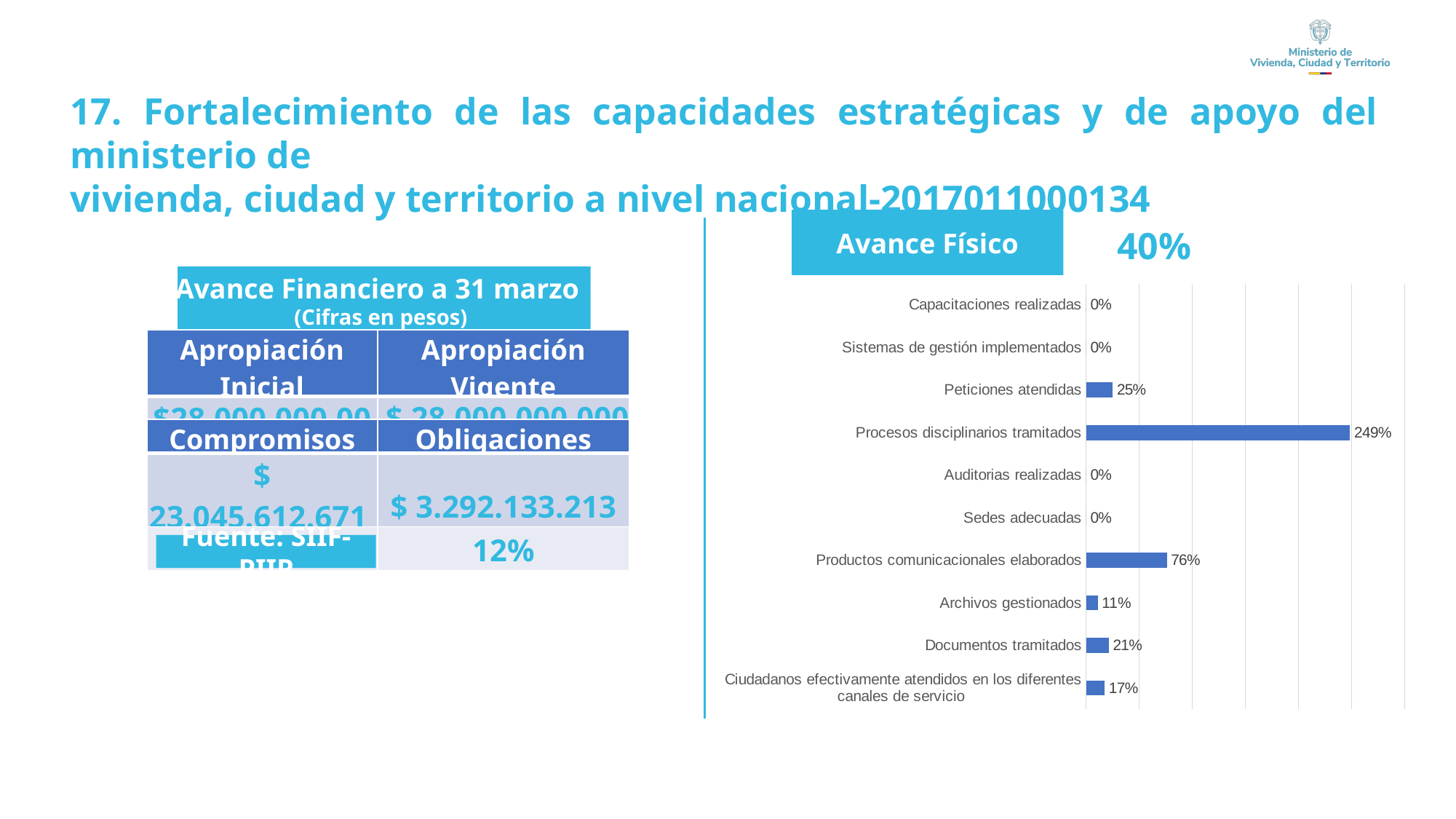
What overall percentage is shown next to the "Avance Físico" heading? 40% In the Avance Físico chart, what is the value for Productos comunicacionales elaborados? 76% In the Avance Físico chart, what is the value for Procesos disciplinarios tramitados? 249% In the Avance Físico chart, what is the difference between Productos comunicacionales elaborados and Peticiones atendidas? 51% In the Avance Físico chart, which category has the highest value? Procesos disciplinarios tramitados In the Avance Físico chart, which is larger: Documentos tramitados or Archivos gestionados? Documentos tramitados In the Avance Físico chart, what is the value for Peticiones atendidas? 25% In the Avance Físico chart, what is the value for Ciudadanos efectivamente atendidos en los diferentes canales de servicio? 17% What type of chart is shown under the heading "Avance Físico"? bar chart In the Avance Físico chart, what is the difference between Documentos tramitados and Archivos gestionados? 10% In the Avance Físico chart, how many categories are plotted? 10 In the Avance Físico chart, how many categories show a value of 0%? 4